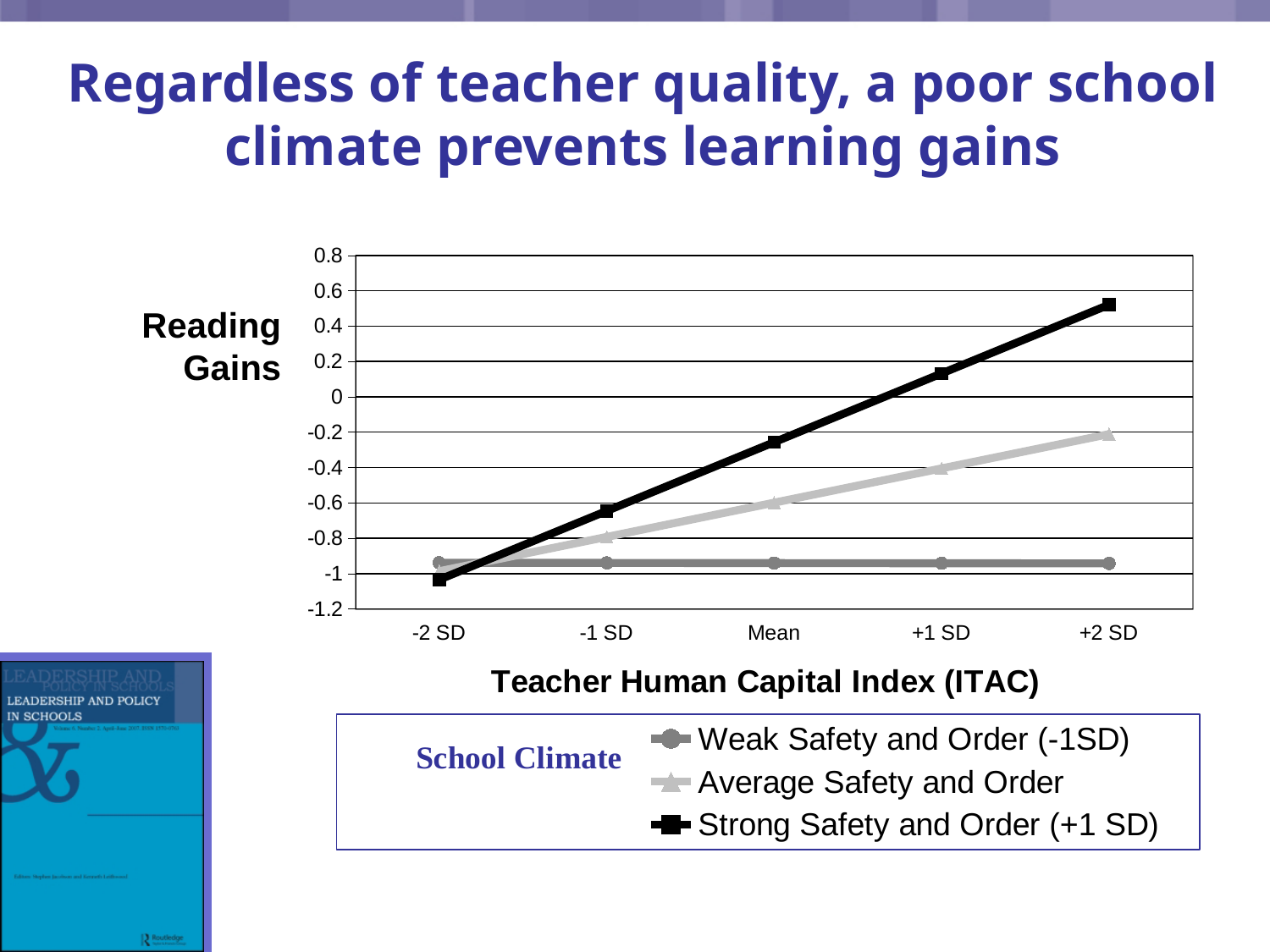
How many categories are shown along the x axis? 5 Is the value for Average Safety and Order at +2 SD greater or less than -0.4? greater What is the title of the x axis? Teacher Human Capital Index (ITAC) Is the value for Strong Safety and Order (+1 SD) at Mean greater or less than 0? less Does the Weak Safety and Order (-1SD) line rise, fall, or stay flat across the x axis? stay flat Is the value for Strong Safety and Order (+1 SD) at +2 SD greater or less than 0.4? greater At Mean, which is larger: the Average Safety and Order value or the Weak Safety and Order (-1SD) value? Average Safety and Order What kind of chart is shown on the slide? line chart Does the Strong Safety and Order (+1 SD) line rise or fall from -2 SD to +2 SD? rise How many series does the legend list? 3 Which series has the lowest value at +2 SD? Weak Safety and Order (-1SD) Which series has the highest value at +2 SD? Strong Safety and Order (+1 SD)